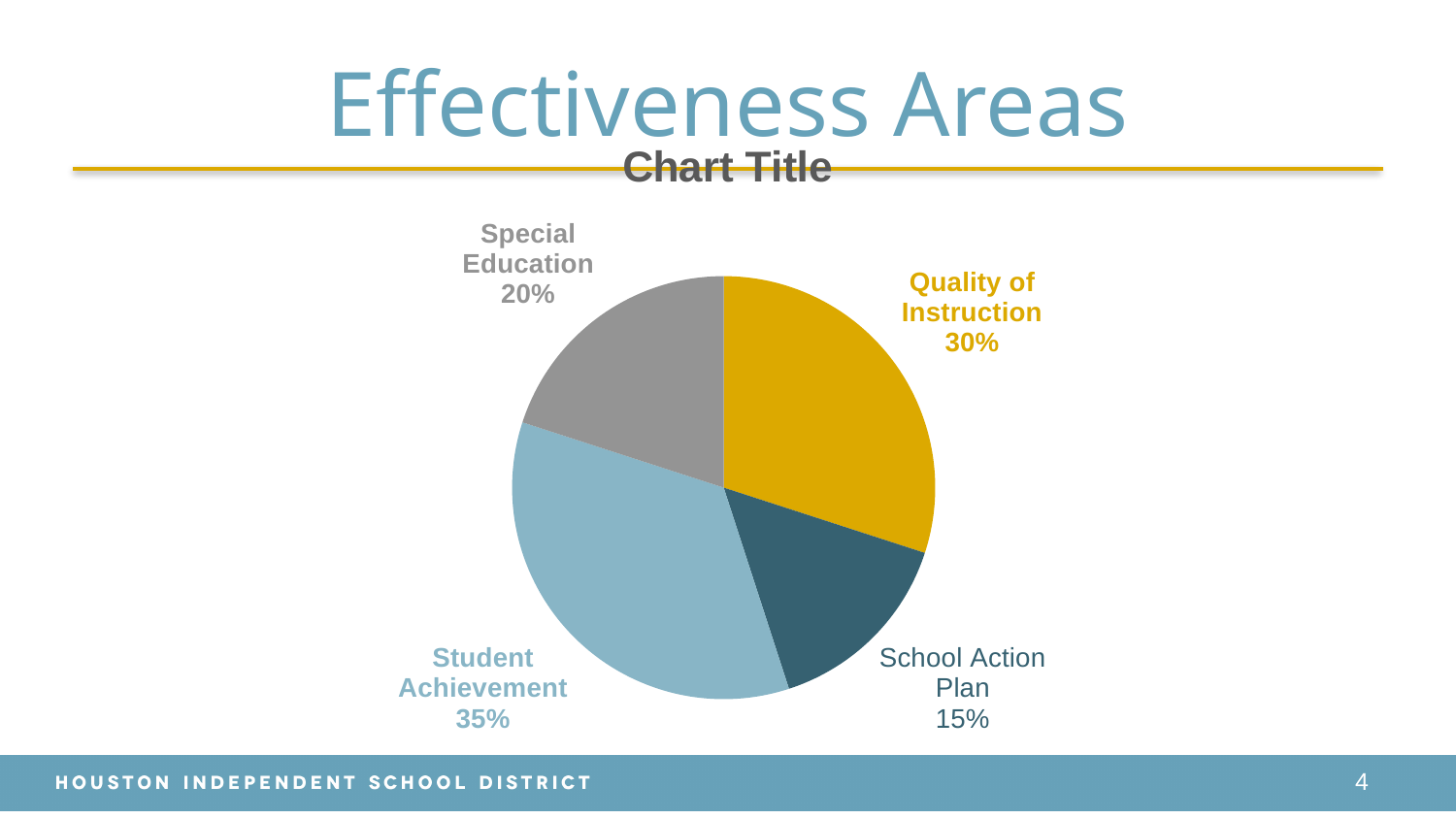
What colour is the Quality of Instruction slice? gold What is the title printed above the pie chart? Chart Title Which is larger, Quality of Instruction or Special Education? Quality of Instruction Which slice of the pie is the largest? Student Achievement What is the difference in percentage points between Student Achievement and School Action Plan? 20 What percentage is shown for Student Achievement? 35% How many slices does the pie chart have? 4 What kind of chart is shown on the slide? pie chart Which slice of the pie is the smallest? School Action Plan What percentage is shown for Special Education? 20% What percentage is shown for School Action Plan? 15% What percentage is shown for Quality of Instruction? 30%